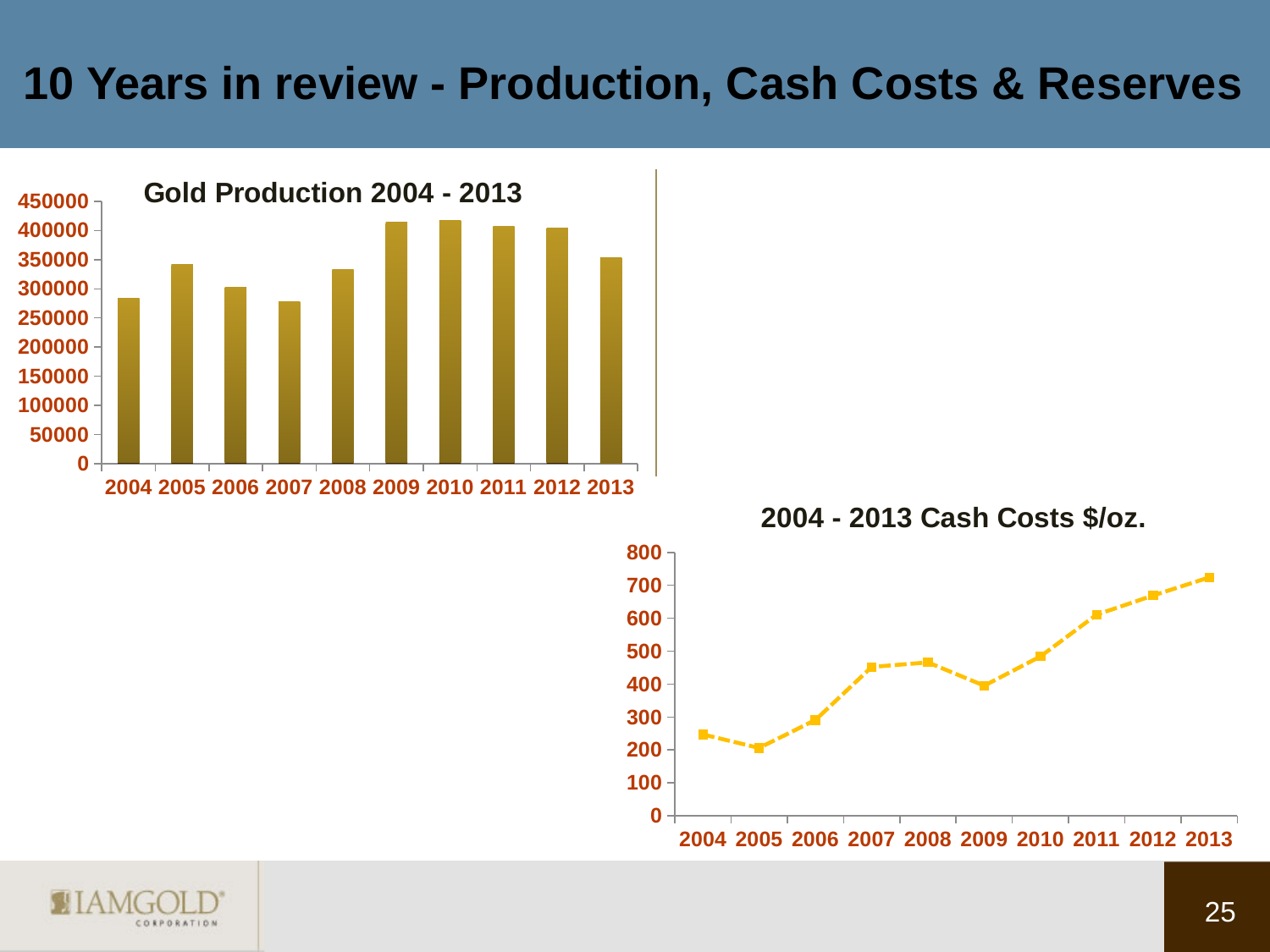
In the Gold Production 2004 - 2013 chart, is the value for 2013 greater or less than 400000? less How many years are shown on the Gold Production 2004 - 2013 chart? 10 In the 2004 - 2013 Cash Costs $/oz. chart, which year has the lowest cash cost? 2005 In the Gold Production 2004 - 2013 chart, is the value for 2004 greater or less than 300000? less In the Gold Production 2004 - 2013 chart, which year has the higher production, 2005 or 2006? 2005 In the Gold Production 2004 - 2013 chart, is the value for 2009 greater or less than 400000? greater In the 2004 - 2013 Cash Costs $/oz. chart, which year has the highest cash cost? 2013 In the 2004 - 2013 Cash Costs $/oz. chart, do cash costs generally rise or fall from 2004 to 2013? rise In the Gold Production 2004 - 2013 chart, which year has the higher production, 2009 or 2013? 2009 What kind of chart is the 2004 - 2013 Cash Costs $/oz. chart? line chart What kind of chart is the Gold Production 2004 - 2013 chart? bar chart